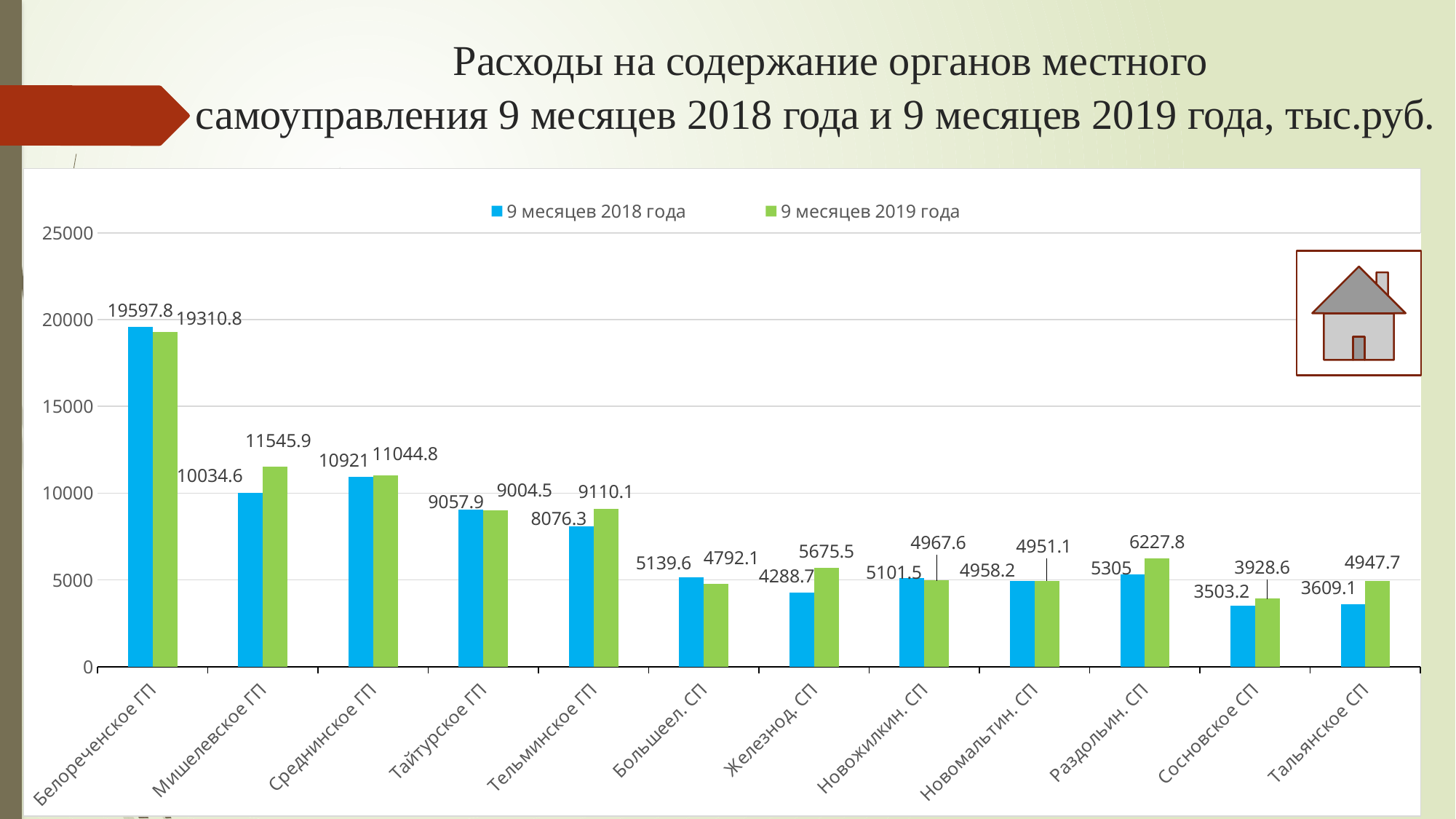
What is the value for Мишелевское ГП in the 9 месяцев 2019 года series? 11545.9 Which category has the highest value in the 9 месяцев 2018 года series? Белореченское ГП Which category has the lowest value in the 9 месяцев 2019 года series? Сосновское СП How many series does the legend list? 2 What kind of chart is shown on the slide? bar chart What is the difference between the 9 месяцев 2018 года and 9 месяцев 2019 года values for Белореченское ГП? 287 For Раздольин. СП, which series has the larger value: 9 месяцев 2018 года or 9 месяцев 2019 года? 9 месяцев 2019 года Is the 9 месяцев 2018 года value for Среднинское ГП greater or less than 10000? greater How many categories are shown on the x axis of the chart? 12 What is the value for Сосновское СП in the 9 месяцев 2018 года series? 3503.2 What is the value for Тельминское ГП in the 9 месяцев 2018 года series? 8076.3 What is the difference between the 9 месяцев 2019 года and 9 месяцев 2018 года values for Железнод. СП? 1386.8